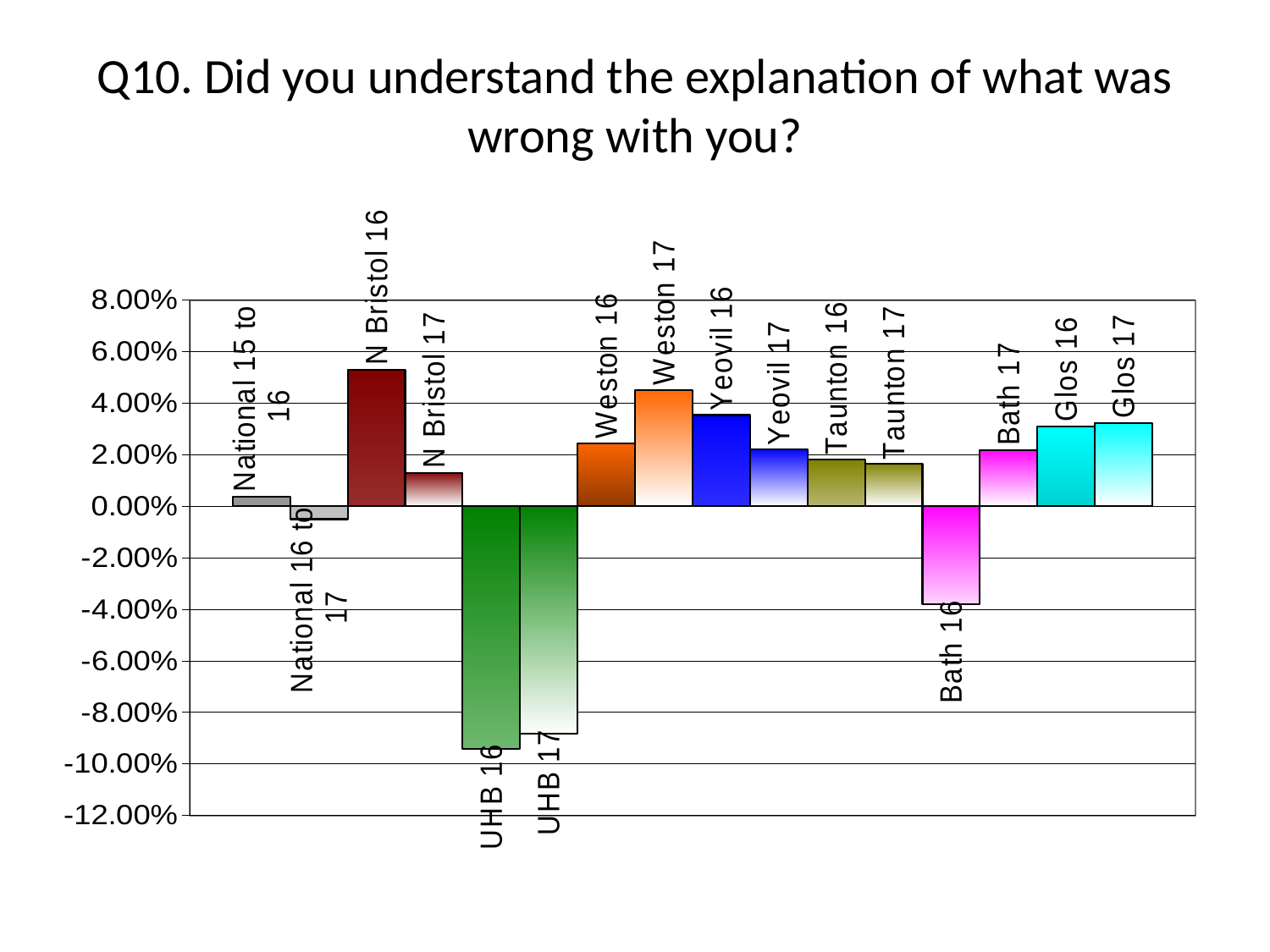
Which is larger, the value for Bath 16 or the value for Bath 17? Bath 17 Which category has the highest value in the chart? N Bristol 16 Is the value for N Bristol 16 greater or less than 4.00%? greater What kind of chart is shown on the slide? bar chart What is the title of the slide containing the chart? Q10. Did you understand the explanation of what was wrong with you? Which is larger, the value for Weston 16 or the value for Weston 17? Weston 17 Is the value for Bath 16 greater or less than -2.00%? less Is the value for UHB 16 greater or less than -8.00%? less Which category has the lowest value in the chart? UHB 16 How many bars (categories) are plotted in the chart? 16